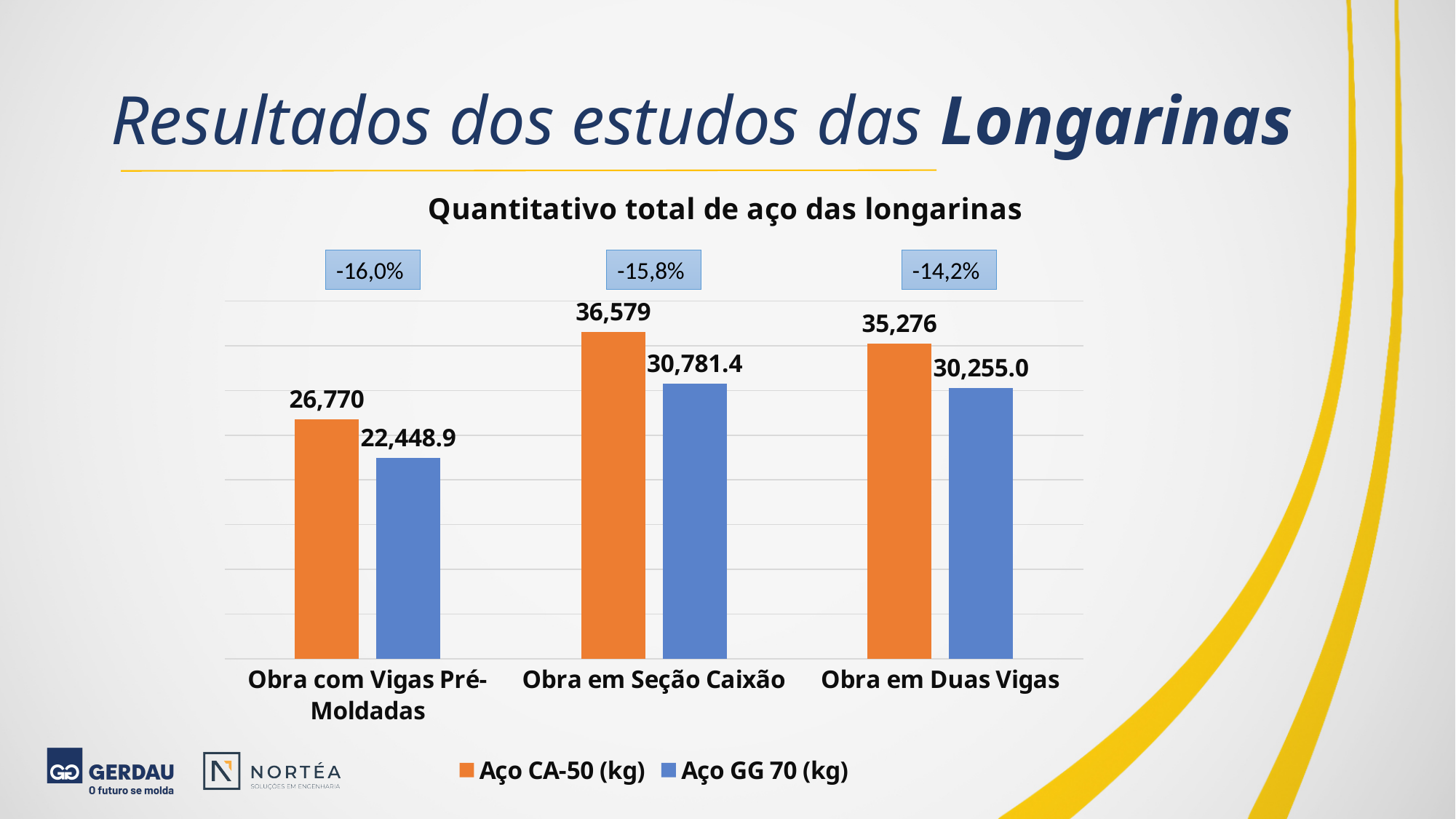
What kind of chart is shown on the slide? Bar chart What is the value of Aço GG 70 (kg) for Obra em Duas Vigas? 30,255.0 How many series does the legend list? 2 Which category has the lowest Aço GG 70 (kg) value? Obra com Vigas Pré-Moldadas What is the difference between Aço CA-50 (kg) and Aço GG 70 (kg) for Obra em Duas Vigas? 5,021.0 Which category has the highest Aço CA-50 (kg) value? Obra em Seção Caixão What percentage label is shown above the Obra em Seção Caixão bars? -15,8% What is the value of Aço CA-50 (kg) for Obra em Seção Caixão? 36,579 Which is larger for Obra com Vigas Pré-Moldadas: Aço CA-50 (kg) or Aço GG 70 (kg)? Aço CA-50 (kg) How many categories are shown on the x axis? 3 What is the title of the chart? Quantitativo total de aço das longarinas What is the value of Aço GG 70 (kg) for Obra com Vigas Pré-Moldadas? 22,448.9